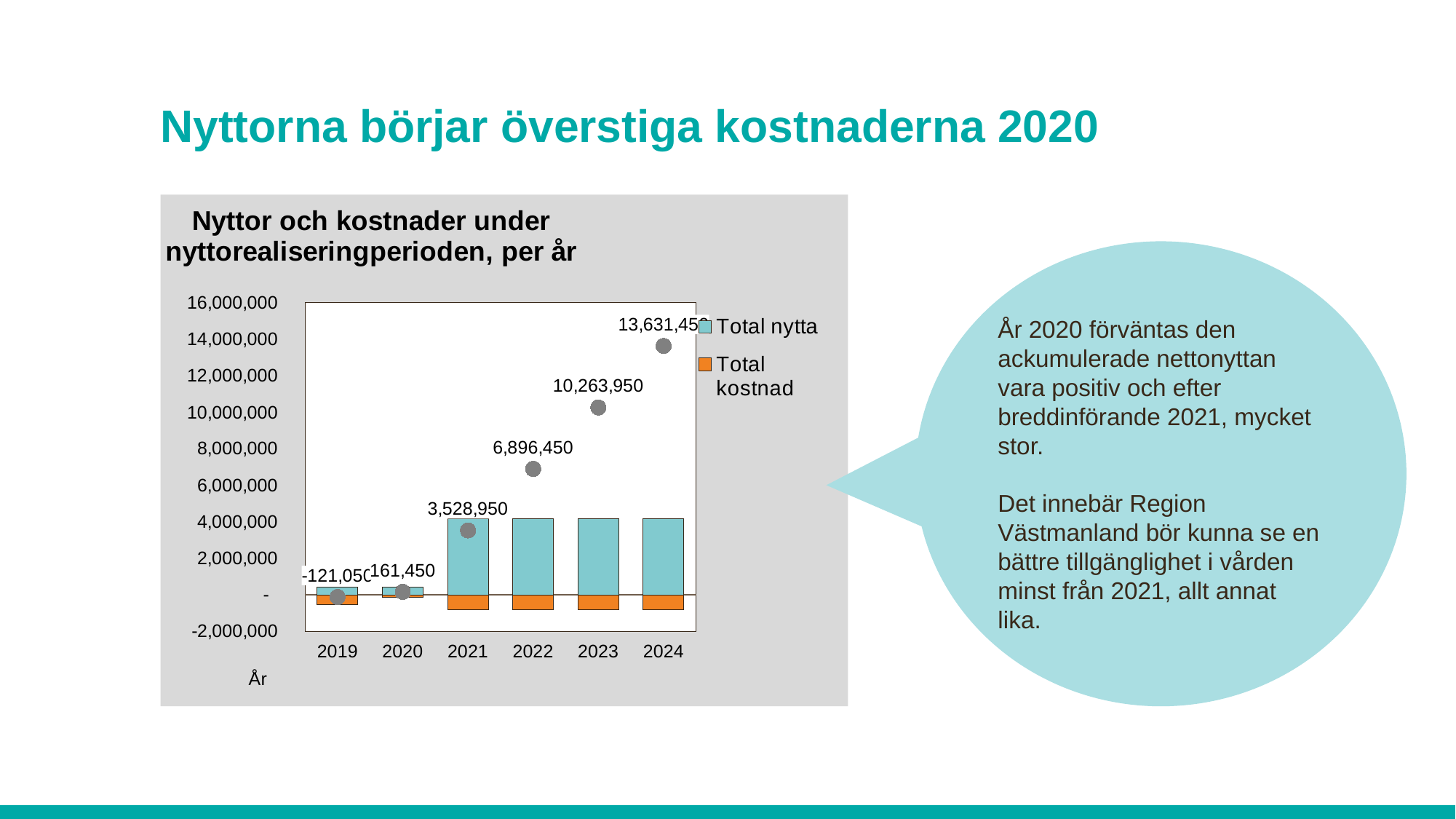
What is the difference between the labelled values for 2023 and 2022? 3,367,500 How many years are shown on the x axis of the chart? 6 Which year has the lowest labelled value on the chart? 2019 Which year has the highest plotted point on the chart? 2024 What is the labelled value for 2023 on the chart? 10,263,950 Which is larger, the labelled value for 2022 or for 2021? 2022 What is the labelled value for 2020 on the chart? 161,450 How many series does the chart's legend list? 2 What is the labelled value for 2021 on the chart? 3,528,950 What is the labelled value for 2022 on the chart? 6,896,450 Is the Total nytta value for 2019 greater or less than 2,000,000? less What is the labelled value for 2019 on the chart? -121,050